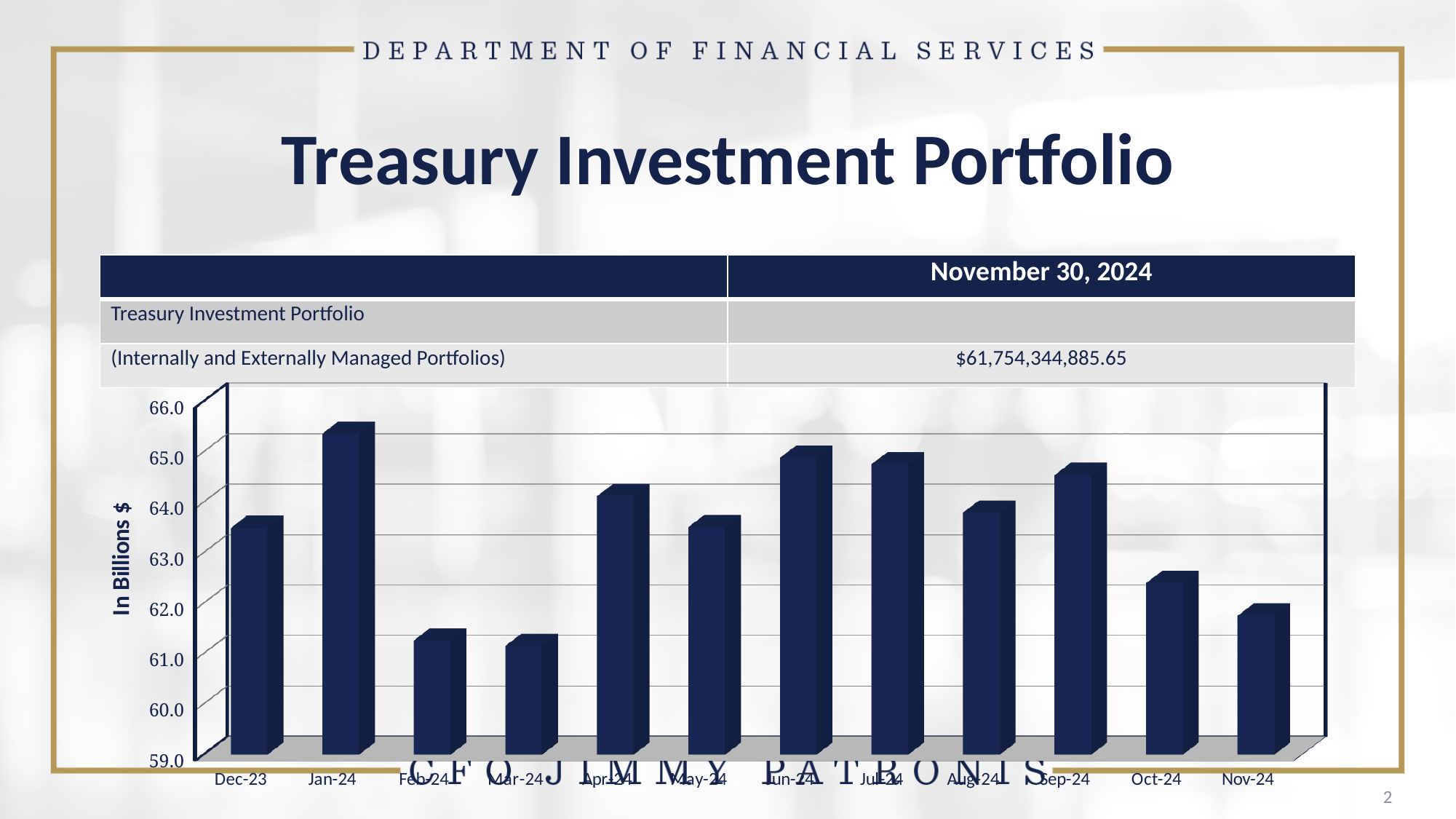
Is the value for Jan-24 greater or less than 65.0? greater Is the value for Feb-24 greater or less than 62.0? less Do the values rise or fall from Jun-24 to Nov-24? fall Which month has the highest value on the chart? Jan-24 Is the value for Oct-24 greater or less than 63.0? less What kind of chart is shown on the slide? bar chart Which is larger, the value for Oct-24 or the value for Nov-24? Oct-24 How many months are plotted on the chart? 12 What is the label on the vertical axis of the chart? In Billions $ Which is larger, the value for Dec-23 or the value for Jan-24? Jan-24